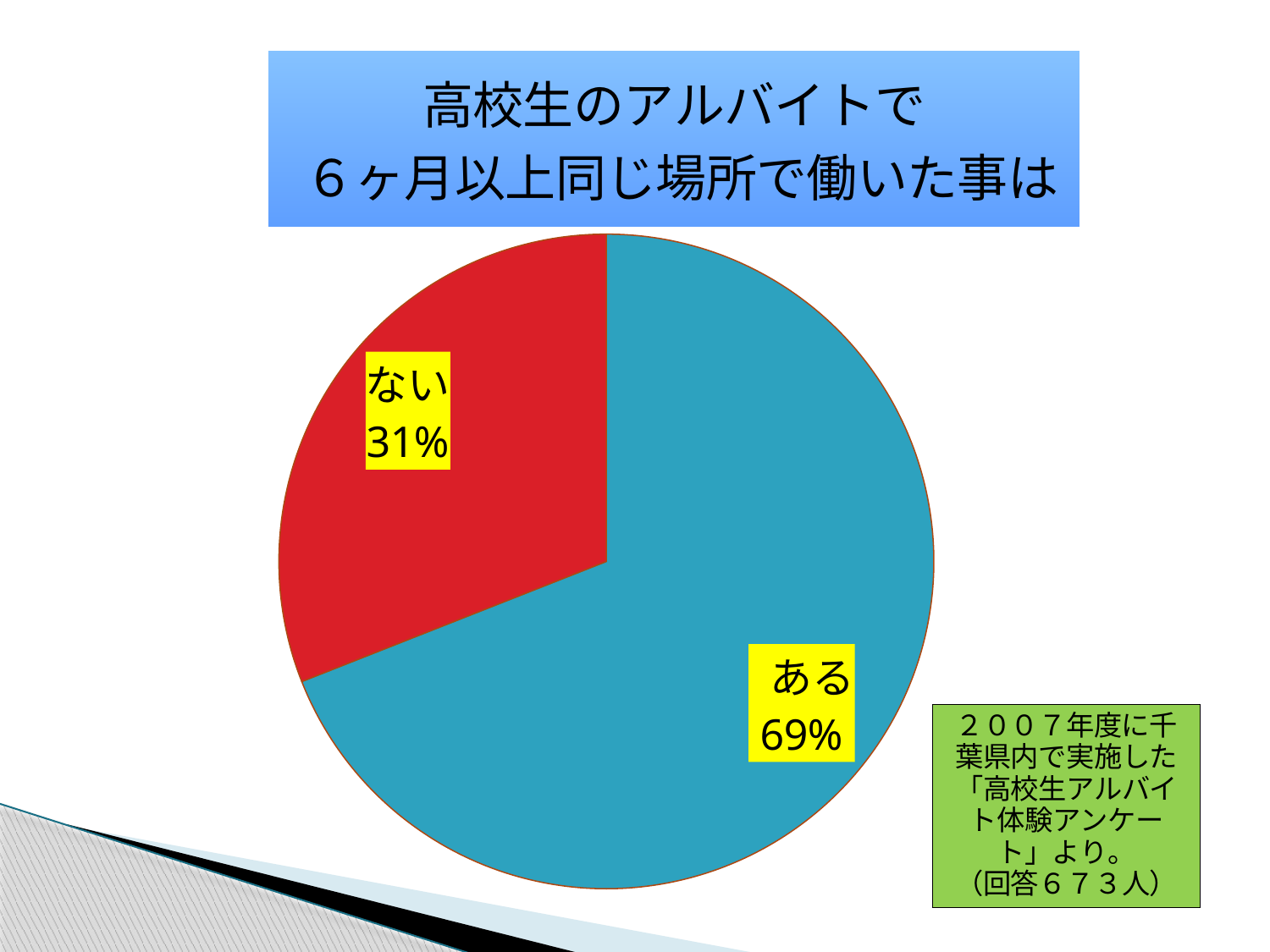
How many slices does the pie chart have? 2 What colour is the ない slice? red Which is larger, the ある slice or the ない slice? ある What is the difference in percentage points between the ある and ない slices? 38 What colour is the ある slice? blue What share of the pie does the ない slice represent? 31% Which slice is the largest? ある Which slice is the smallest? ない What percentage is shown for the ない slice? 31% What percentage is shown for the ある slice? 69% What kind of chart is shown on the slide? pie chart